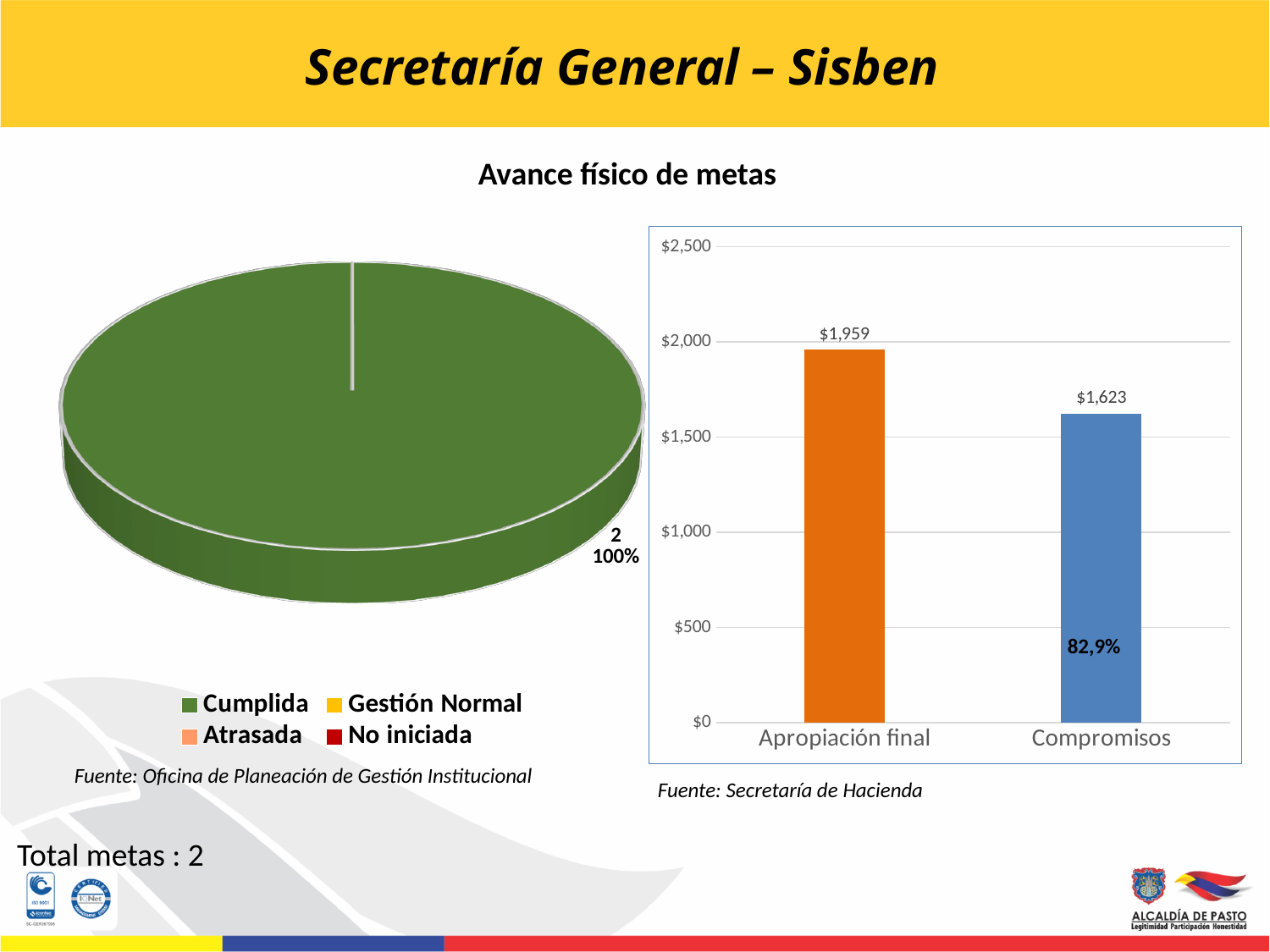
What kind of chart is the chart on the left of the slide? pie chart What kind of chart is the chart on the right of the slide? bar chart In the bar chart on the right, how many categories are shown on the x axis? 2 In the bar chart on the right, is the value for Compromisos greater or less than $1,500? greater In the bar chart on the right, what percentage label is printed on the Compromisos bar? 82,9% In the pie chart on the left (Avance físico de metas), what share of the pie does the Cumplida slice represent? 100% In the bar chart on the right, what is the value for Compromisos? $1,623 In the bar chart on the right, what is the difference between Apropiación final and Compromisos? $336 In the pie chart on the left (Avance físico de metas), how many entries does the legend list? 4 In the bar chart on the right, which category has the lower value? Compromisos In the bar chart on the right, what is the value for Apropiación final? $1,959 In the bar chart on the right, which category has the higher value? Apropiación final